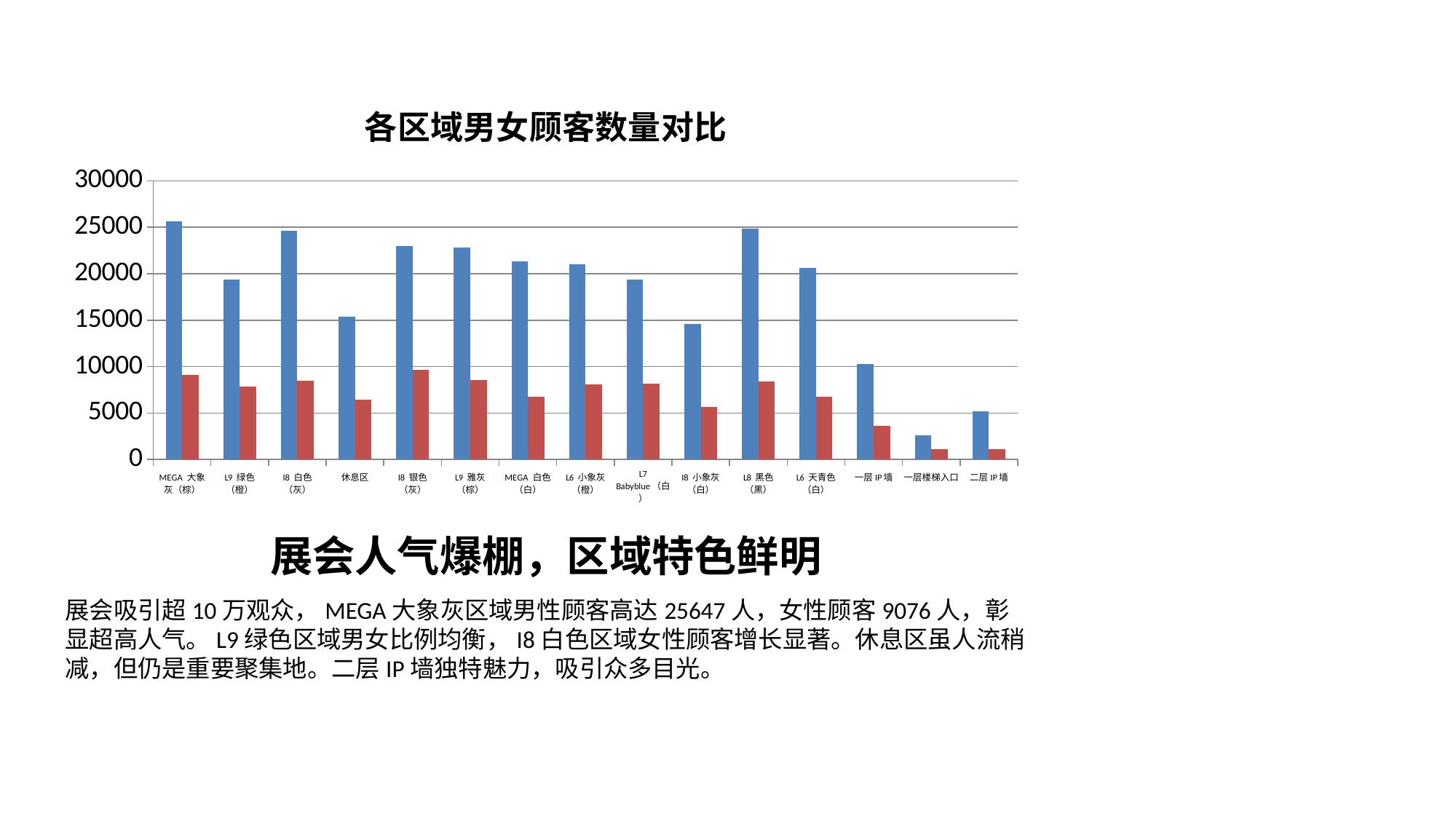
Which has the taller red bar, L8 黑色（黑） or 一层 IP 墙? L8 黑色（黑） Which has the taller blue bar, I8 白色（灰） or 休息区? I8 白色（灰） Is the red bar for MEGA 白色（白） greater or less than 10000? less Which category has the tallest blue bar? MEGA 大象灰（棕） How many categories (regions) are shown on the x axis of the chart? 15 What kind of chart is shown on the slide? bar chart What is the title of the chart? 各区域男女顾客数量对比 Which category has the shortest blue bar? 一层楼梯入口 Is the blue bar for 休息区 greater or less than 10000? greater Is the blue bar for L9 绿色（橙） greater or less than 20000? less